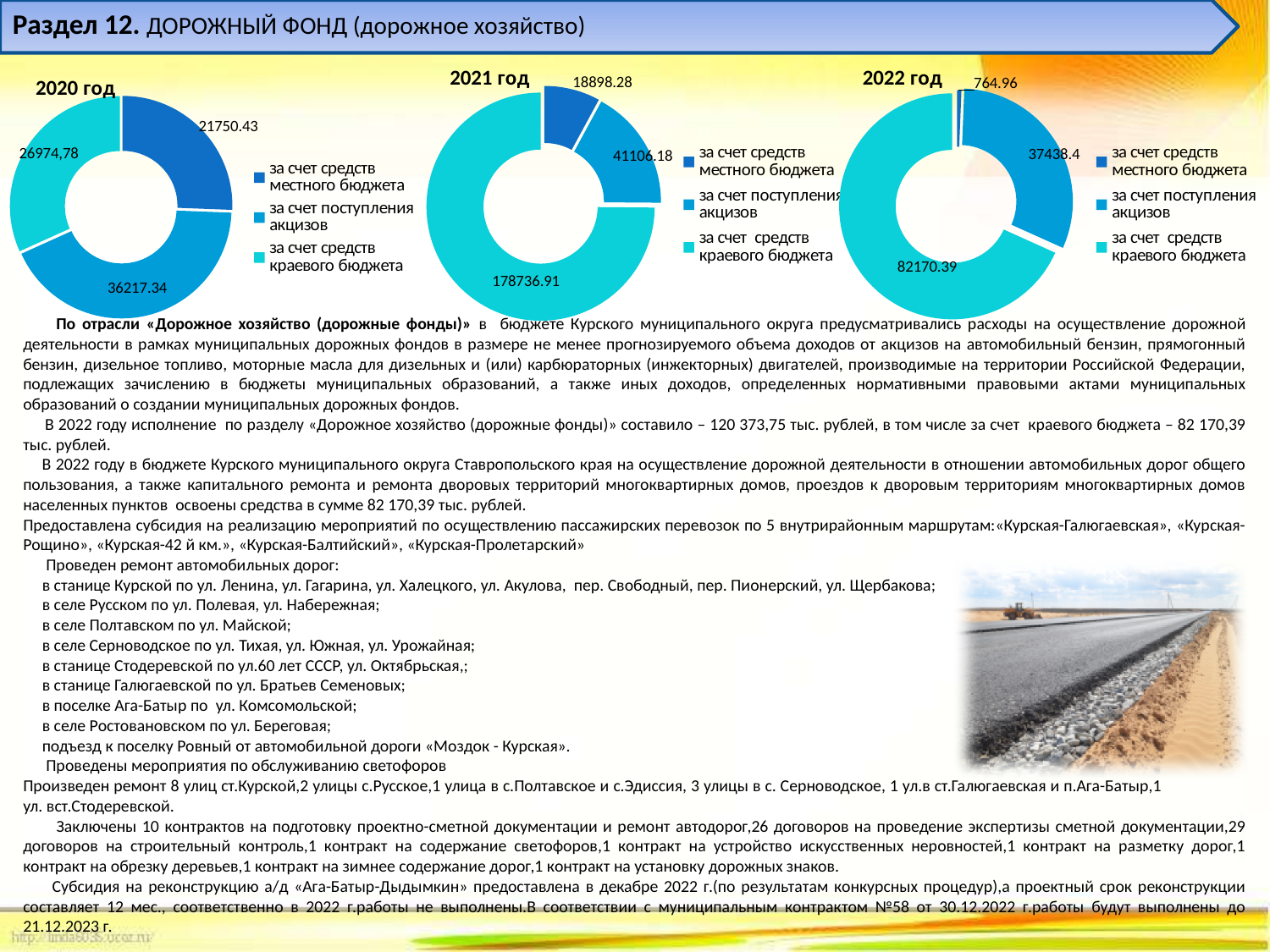
In the 2021 год chart, which is larger: за счет поступления акцизов or за счет средств местного бюджета? за счет поступления акцизов In the 2022 год chart, what is the value for за счет средств краевого бюджета? 82170.39 What kind of chart is used for the 2021 год data? pie (doughnut) chart In the 2022 год chart, what is the difference between за счет средств краевого бюджета and за счет поступления акцизов? 44731.99 What is the total of all three values in the 2022 год chart? 120373.75 How many categories does the legend of the 2022 год chart list? 3 In the 2022 год chart, which category has the smallest value? за счет средств местного бюджета In the 2021 год chart, what is the value for за счет поступления акцизов? 41106.18 In the 2021 год chart, which category has the largest value? за счет средств краевого бюджета In the 2021 год chart, what is the value for за счет средств краевого бюджета? 178736.91 In the 2022 год chart, what is the value for за счет средств местного бюджета? 764.96 In the 2020 год chart, what is the value for за счет средств местного бюджета? 21750.43